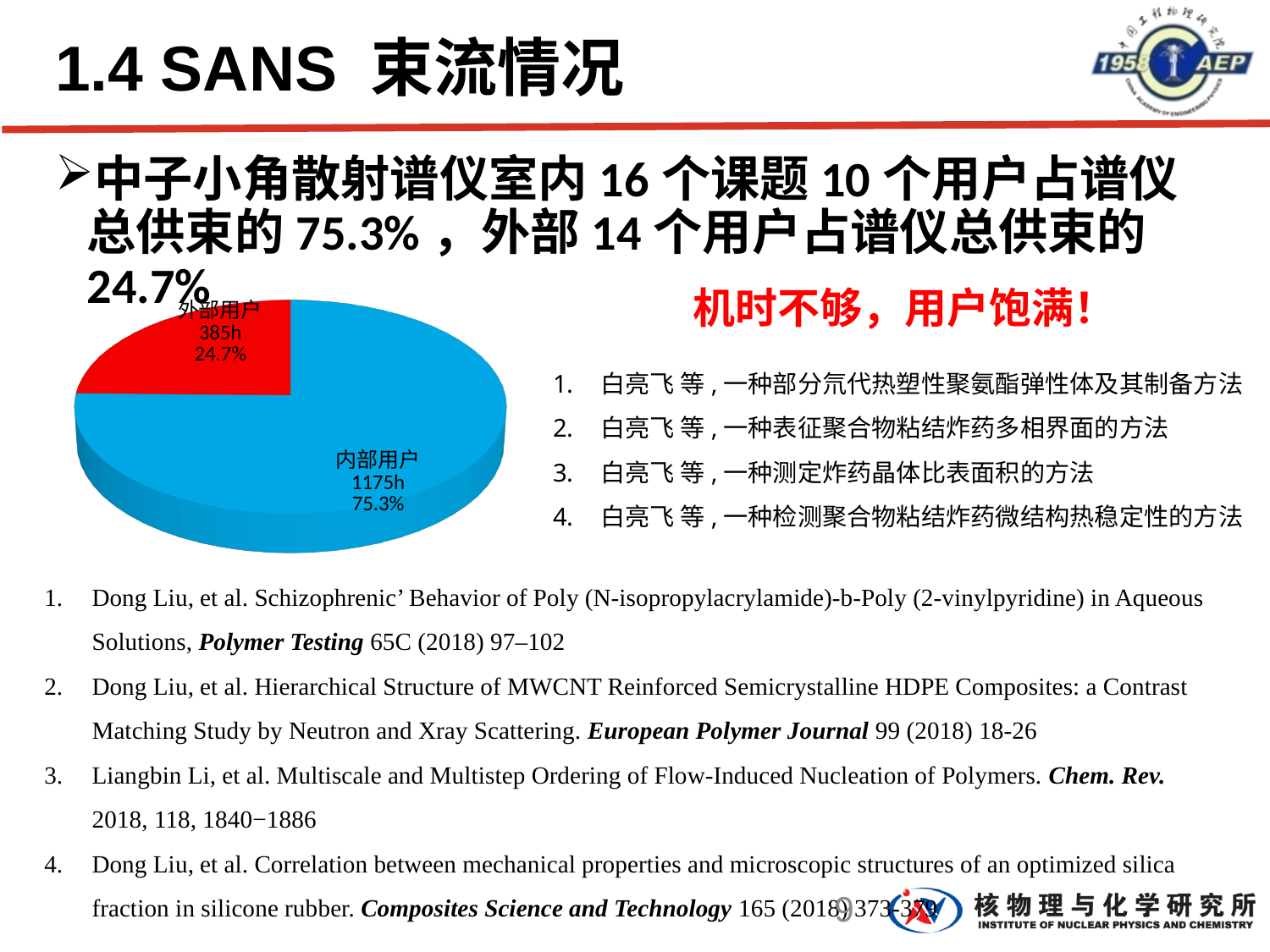
How many slices does the pie chart have? 2 Which has more hours in the pie chart, 内部用户 or 外部用户? 内部用户 What colour is the 外部用户 slice in the pie chart? red What share of the pie does 内部用户 account for? 75.3% How many hours are shown for 内部用户 in the pie chart? 1175h Which slice of the pie chart is the smallest? 外部用户 What share of the pie does 外部用户 account for? 24.7% What kind of chart is shown on the slide? pie chart How many hours are shown for 外部用户 in the pie chart? 385h What is the difference in hours between 内部用户 and 外部用户 in the pie chart? 790h Which slice of the pie chart is the largest? 内部用户 What is the total number of hours across both slices of the pie chart? 1560h